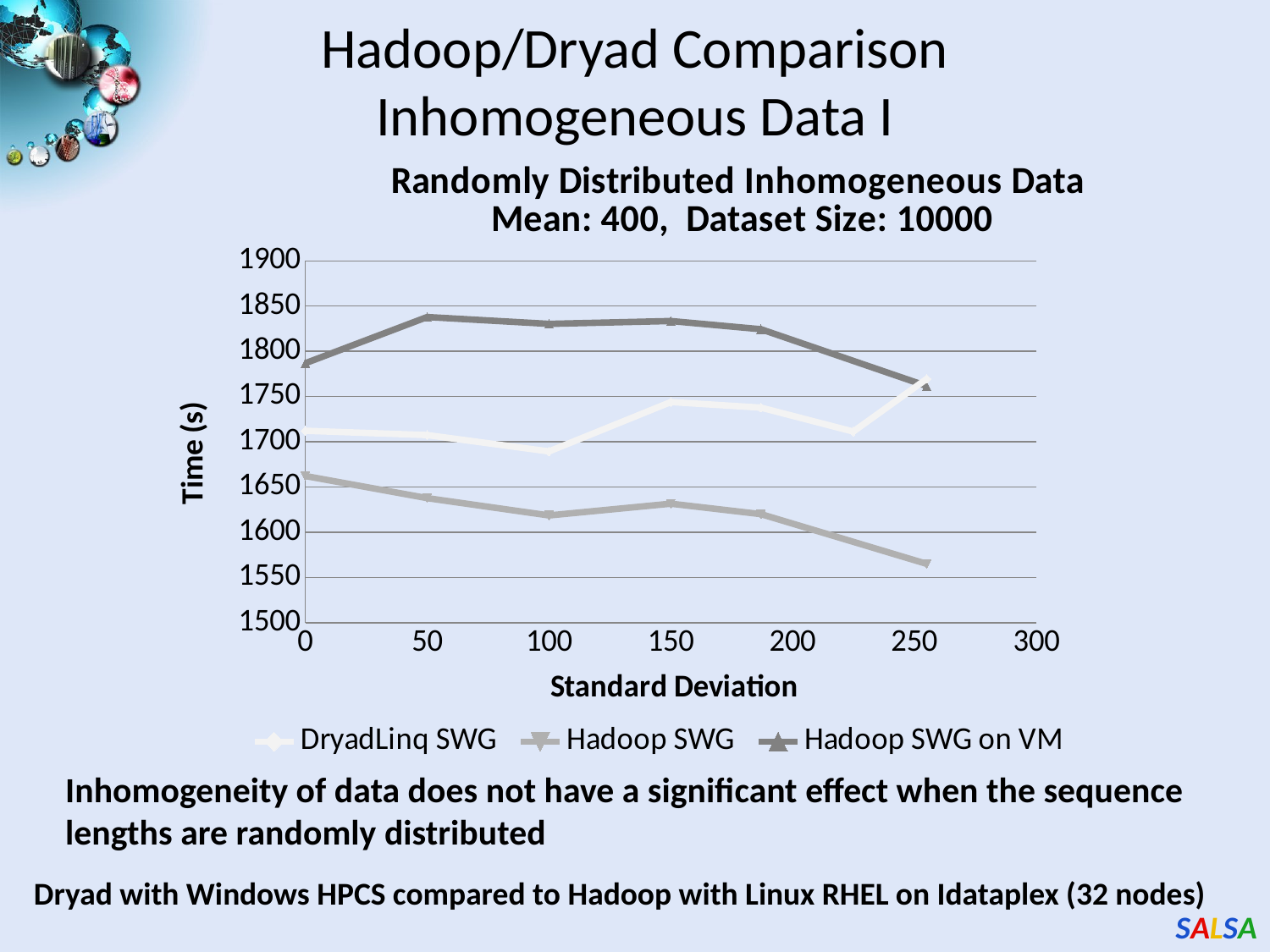
How many series does the chart legend list? 3 Does the Hadoop SWG series rise or fall as standard deviation increases? fall Is the value for Hadoop SWG on VM at standard deviation 50 greater or less than 1800? greater Is the value for Hadoop SWG at standard deviation 250 greater or less than 1600? less Is the value for Hadoop SWG at standard deviation 100 greater or less than 1650? less What is the title of the chart? Randomly Distributed Inhomogeneous Data Mean: 400, Dataset Size: 10000 What kind of chart is shown on the slide? line chart Which series has the lowest time values across the chart? Hadoop SWG Which series has the highest time values across the chart? Hadoop SWG on VM What is the label of the y axis of the chart? Time (s) At standard deviation 50, which is larger: Hadoop SWG on VM or Hadoop SWG? Hadoop SWG on VM